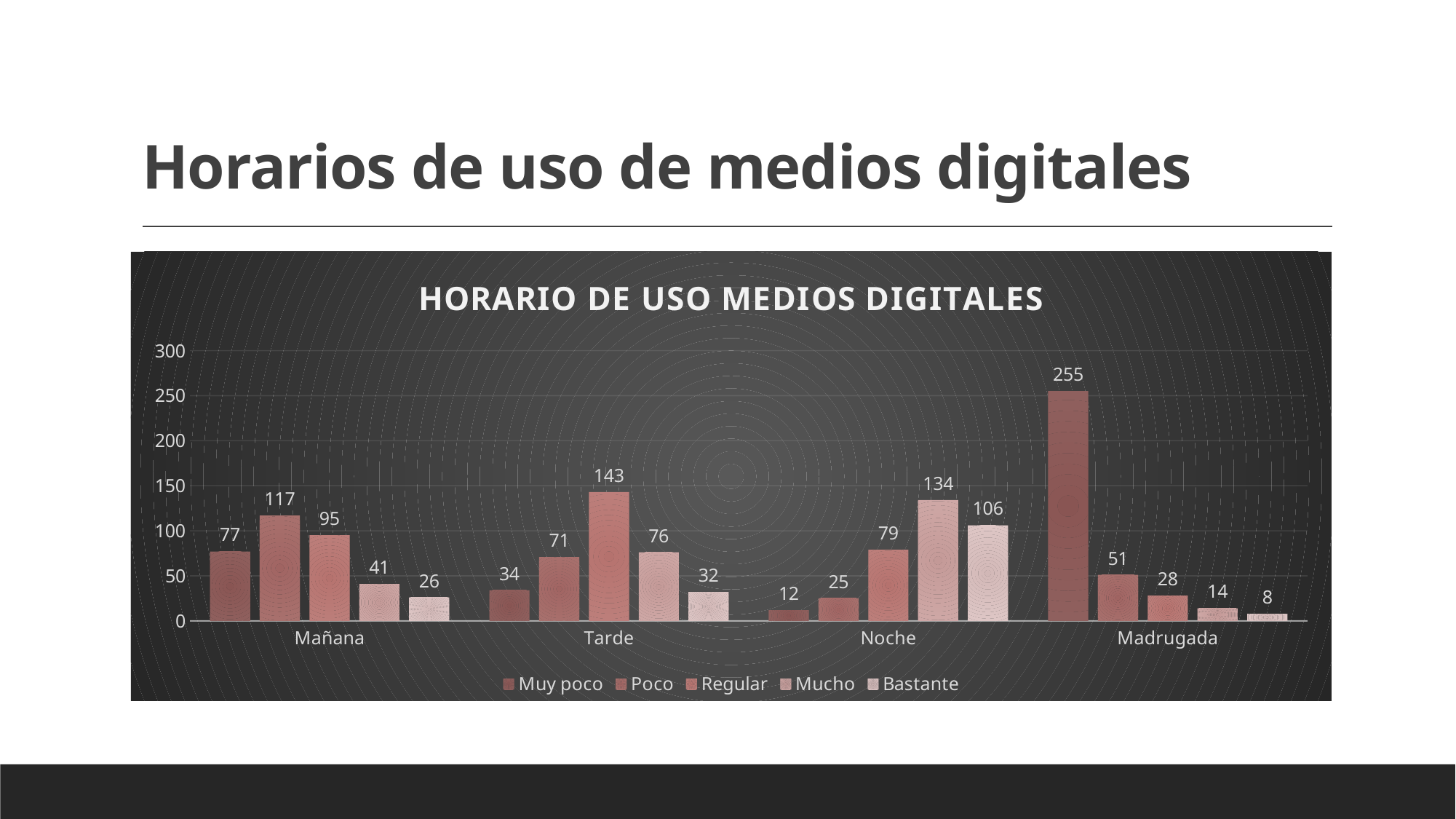
What is the difference between the Muy poco value for Madrugada and the Regular value for Tarde? 112 What is the value for Mucho in the Noche group? 134 What is the title of the chart? HORARIO DE USO MEDIOS DIGITALES What is the value for Regular in the Tarde group? 143 How many series does the legend list? 5 Which is larger: the Mucho value for Noche or the Poco value for Mañana? Mucho value for Noche Which series has the lowest value in the Noche group? Muy poco Which series has the highest value in the Madrugada group? Muy poco What is the value for Poco in the Mañana group? 117 How many time-of-day categories are shown on the x axis? 4 What is the value for Bastante in the Madrugada group? 8 What kind of chart is shown on the slide? Bar chart